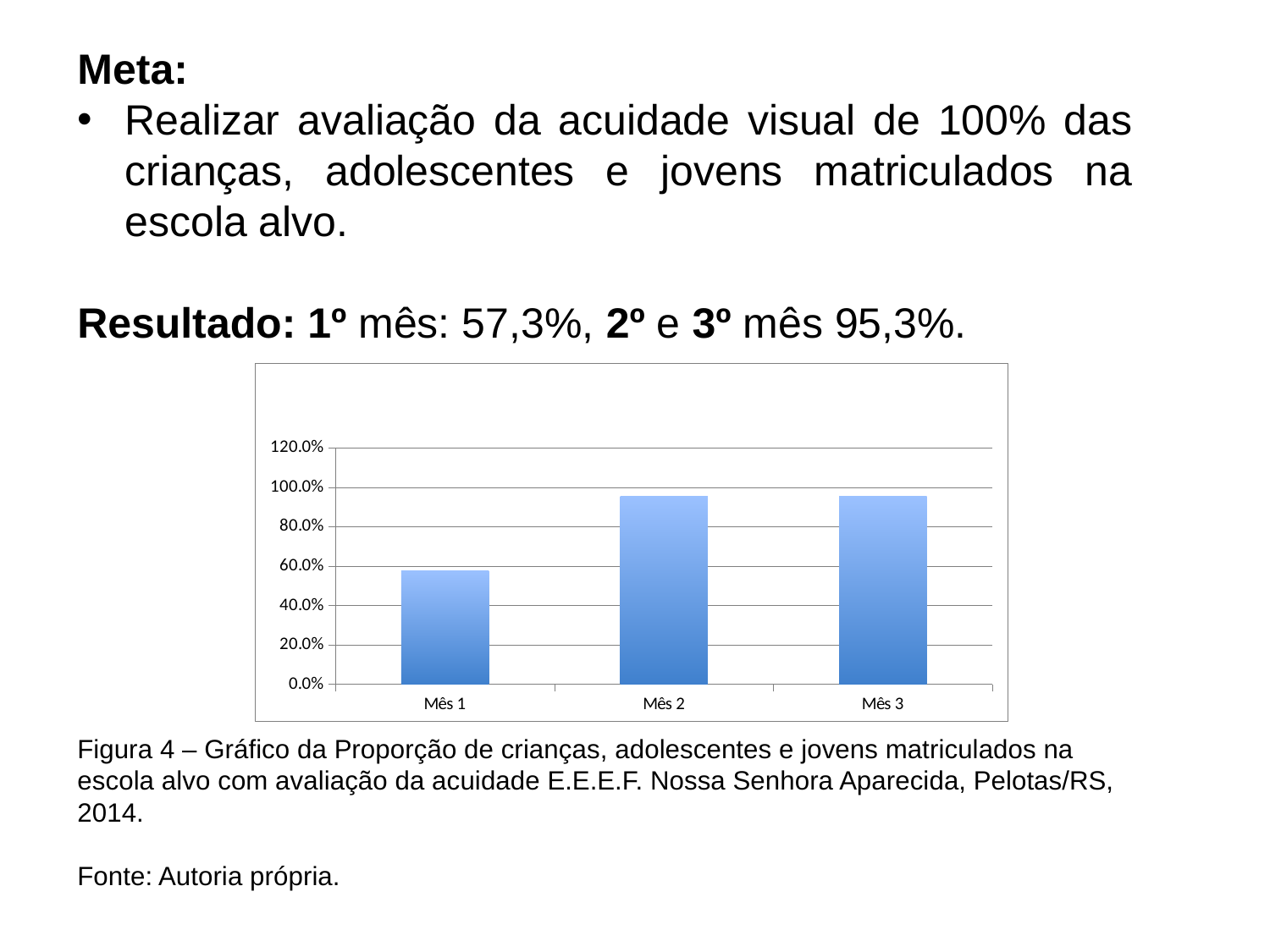
Which is larger, the value for Mês 1 or the value for Mês 2? Mês 2 How many categories (months) are shown on the x axis of the chart? 3 Is the value for Mês 2 greater or less than 80.0%? greater What kind of chart is shown on the slide? bar chart Is the value for Mês 3 greater or less than 100.0%? less Do the values rise or fall from Mês 1 to Mês 2? rise Which month has the lowest bar in the chart? Mês 1 Is the value for Mês 1 greater or less than 40.0%? greater What is the label of the first category on the x axis? Mês 1 What is the highest tick value shown on the y axis of the chart? 120.0%